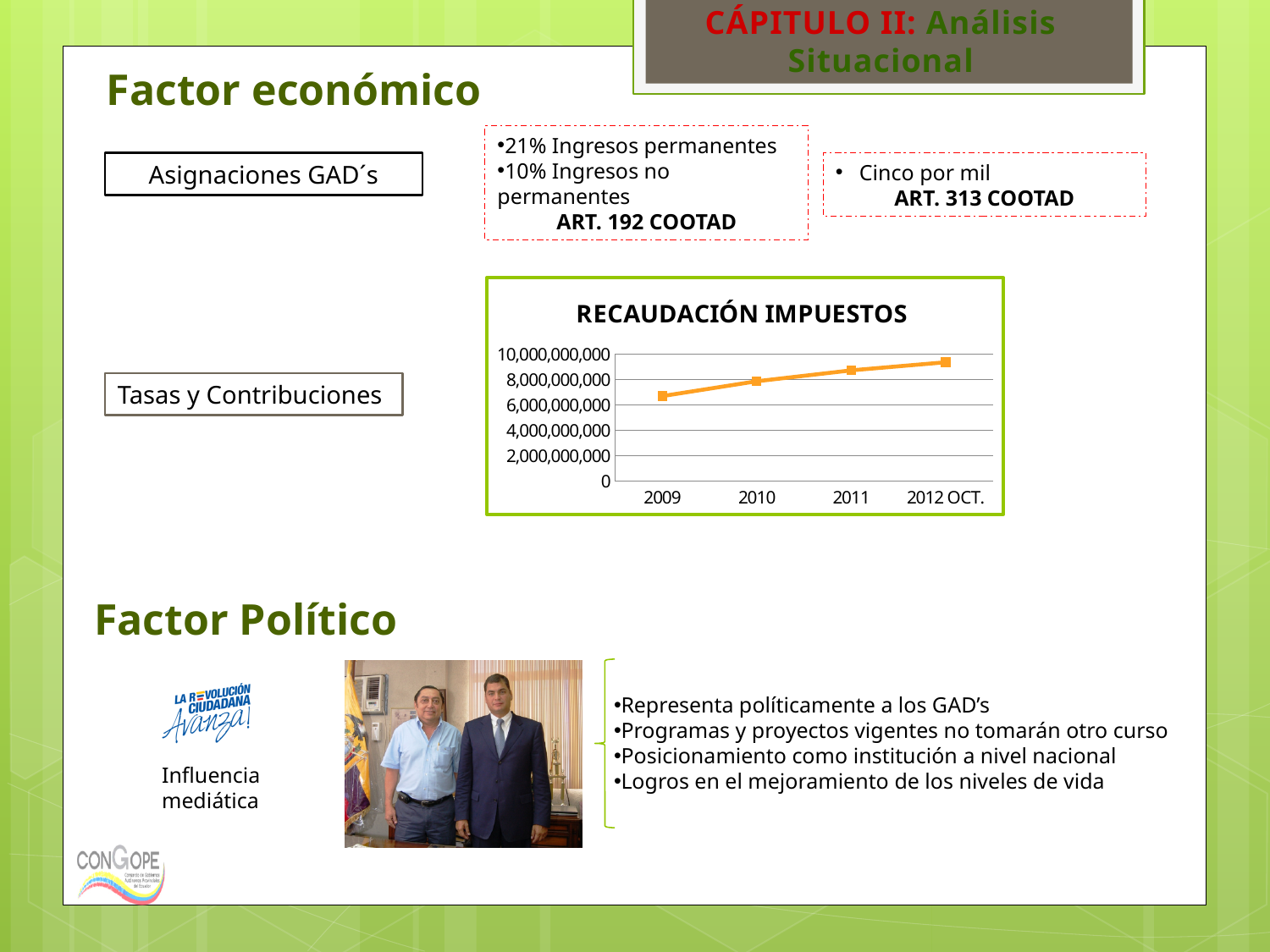
Do the values on the RECAUDACIÓN IMPUESTOS chart rise or fall from 2009 to 2012 OCT.? rise How many points are plotted on the RECAUDACIÓN IMPUESTOS chart? 4 What is the highest value shown on the y axis of the RECAUDACIÓN IMPUESTOS chart? 10,000,000,000 Which category has the highest value on the RECAUDACIÓN IMPUESTOS chart? 2012 OCT. Is the value for 2011 on the RECAUDACIÓN IMPUESTOS chart greater or less than 8,000,000,000? greater Which category has the lowest value on the RECAUDACIÓN IMPUESTOS chart? 2009 Is the value for 2009 on the RECAUDACIÓN IMPUESTOS chart greater or less than 6,000,000,000? greater Is the value for 2012 OCT. on the RECAUDACIÓN IMPUESTOS chart greater or less than 10,000,000,000? less What kind of chart is the RECAUDACIÓN IMPUESTOS chart? line chart What is the title of the chart on the slide? RECAUDACIÓN IMPUESTOS On the RECAUDACIÓN IMPUESTOS chart, which is larger, the value for 2011 or the value for 2009? 2011